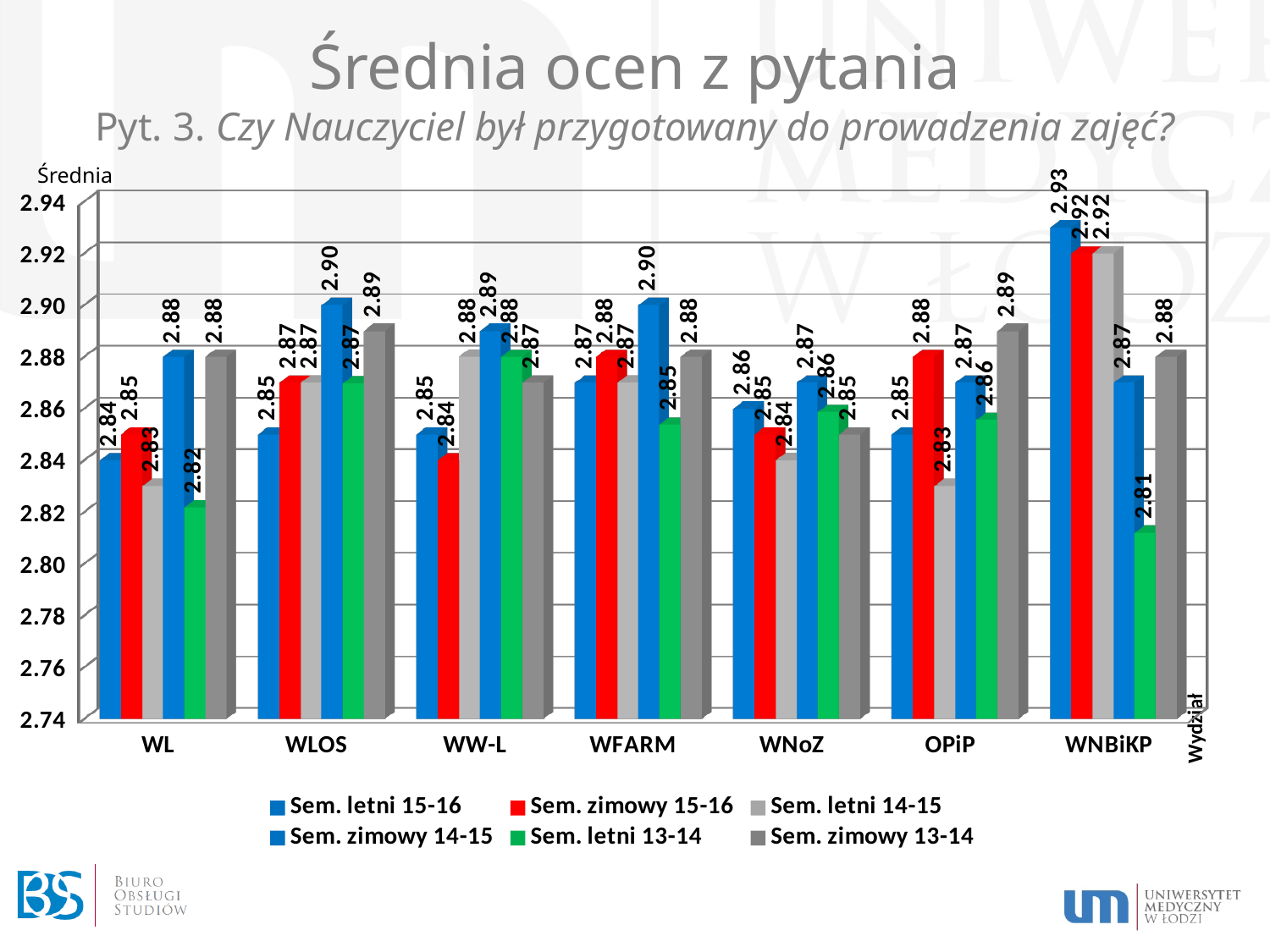
Which faculty has the lowest value for Sem. letni 13-14? WNBiKP What is the value for Sem. letni 14-15 for OPiP? 2.83 What is the difference between the Sem. zimowy 15-16 values for WNBiKP and WW-L? 0.08 What label is shown on the vertical axis of the chart? Średnia Which faculty has the highest value for Sem. zimowy 15-16? WNBiKP How many series does the legend list? 6 What is the value for Sem. zimowy 15-16 for WNBiKP? 2.92 How many faculties (categories) are shown on the x axis? 7 What kind of chart is shown on the slide? bar chart What is the value for Sem. letni 13-14 for WL? 2.82 Which is larger, the Sem. zimowy 13-14 value for WLOS or for WNoZ? WLOS What is the highest value shown anywhere on the chart? 2.93